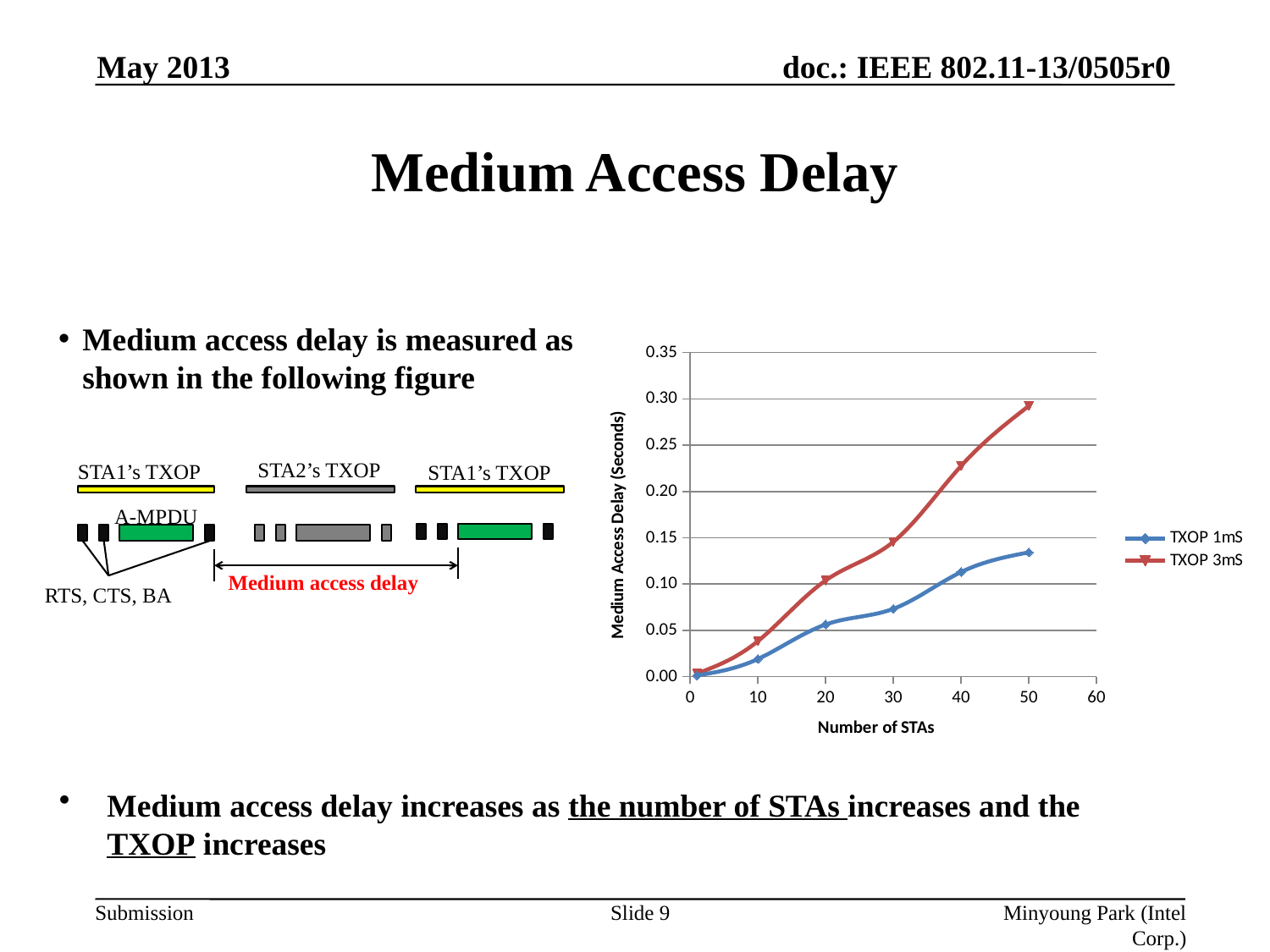
Is the value for TXOP 3mS at 40 STAs greater or less than 0.20? greater How many data points are plotted for the TXOP 3mS series? 6 Is the value for TXOP 3mS at 50 STAs greater or less than 0.25? greater What kind of chart is shown on the slide? line chart Does the medium access delay rise or fall as the number of STAs increases? rise Which series reaches the highest medium access delay on the chart? TXOP 3mS How many series does the chart legend list? 2 Is the value for TXOP 1mS at 50 STAs greater or less than 0.20? less What is the label of the chart's x axis? Number of STAs What are the two series named in the chart legend? TXOP 1mS and TXOP 3mS Which series has the higher medium access delay at 50 STAs, TXOP 1mS or TXOP 3mS? TXOP 3mS